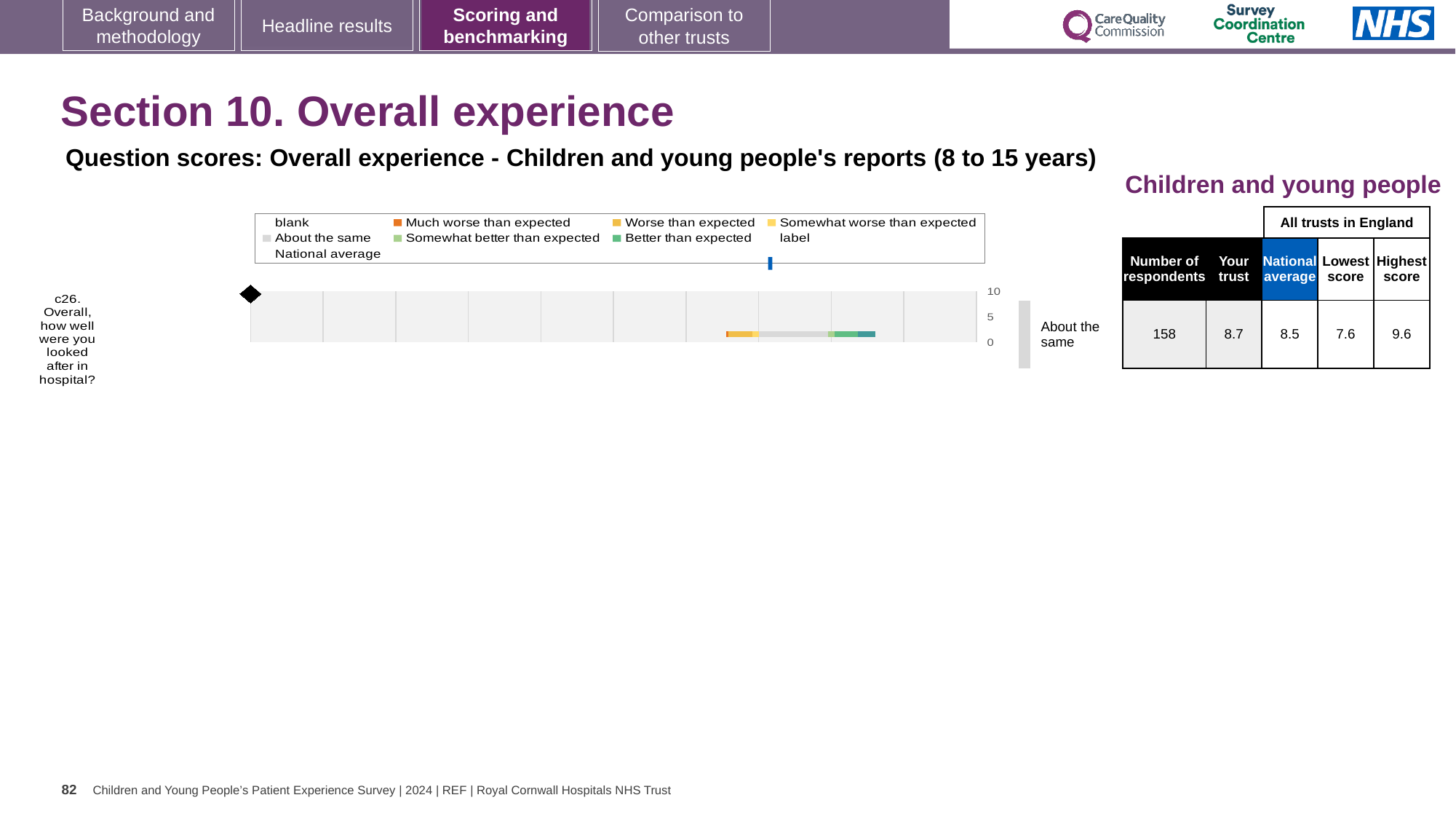
By how much does the trust's score for c26 exceed the national average? 0.2 What benchmark category is the trust's result for question c26 labelled as on the chart? About the same What kind of chart is used to show the question score for c26? bar chart What is the highest score among all trusts in England for question c26? 9.6 How many respondents answered question c26? 158 Which is higher for question c26: the trust's score or the national average? Your trust Is the trust's score for question c26 greater or less than 5 on the chart's axis? greater What is the difference between the highest and lowest trust scores for question c26? 2.0 What is the lowest score among all trusts in England for question c26? 7.6 How many survey questions are plotted on the chart? 1 What is the 'Your trust' score for question c26 'Overall, how well were you looked after in hospital?' 8.7 What is the national average score for question c26? 8.5